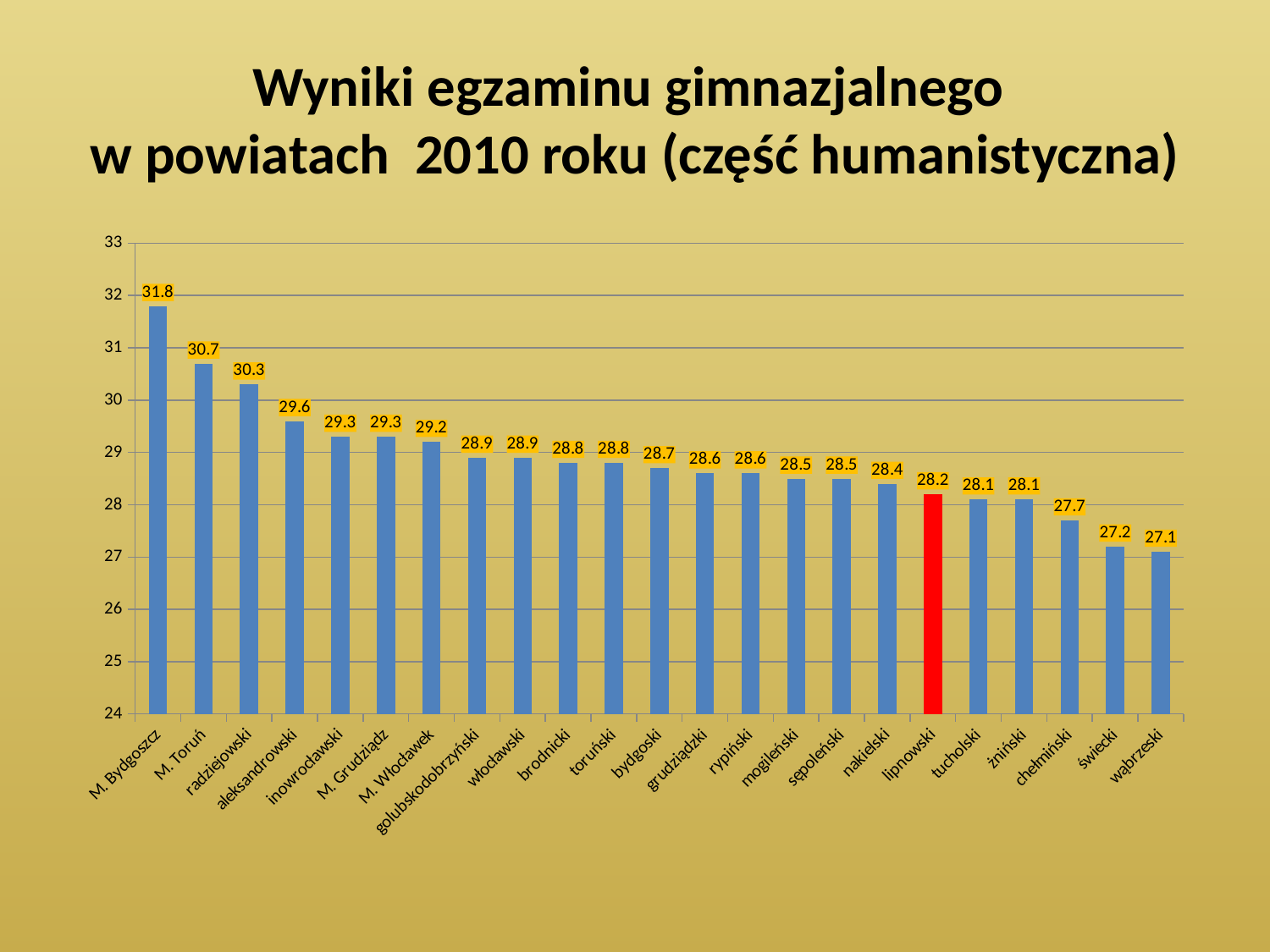
Which category has the lowest value? wąbrzeski What kind of chart is shown on the slide? bar chart Which category's bar is coloured red instead of blue? lipnowski Is the value for nakielski greater or less than 28? greater How many categories are shown on the x axis? 23 What is the difference between the values for M. Bydgoszcz and wąbrzeski? 4.7 Which category has the highest value? M. Bydgoszcz What is the value for chełmiński? 27.7 What is the value for M. Bydgoszcz? 31.8 Which has a larger value, aleksandrowski or świecki? aleksandrowski What is the difference between the values for M. Toruń and radziejowski? 0.4 What is the value for lipnowski? 28.2